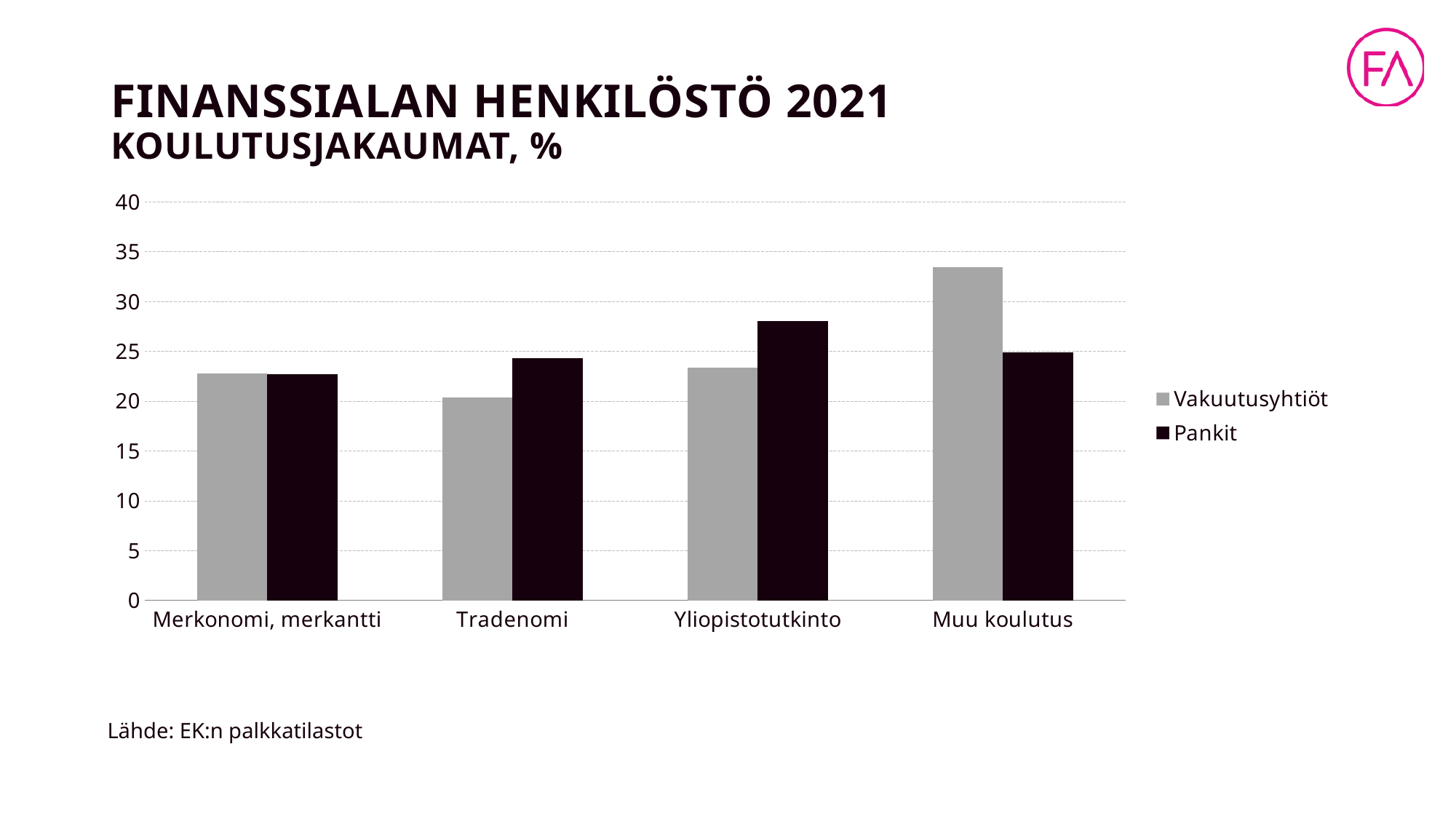
For Tradenomi, which series has the larger value, Vakuutusyhtiöt or Pankit? Pankit For Muu koulutus, which series has the larger value, Vakuutusyhtiöt or Pankit? Vakuutusyhtiöt What kind of chart is shown on the slide? bar chart Which category has the lowest value for Vakuutusyhtiöt? Tradenomi Which category has the highest value for Pankit? Yliopistotutkinto How many series does the legend list? 2 Which category has the lowest value for Pankit? Merkonomi, merkantti Which colour represents Pankit in the legend? black Which category has the highest value for Vakuutusyhtiöt? Muu koulutus Is the value for Pankit in Yliopistotutkinto greater or less than 25? greater How many education categories are shown on the x axis? 4 Is the value for Vakuutusyhtiöt in Muu koulutus greater or less than 30? greater